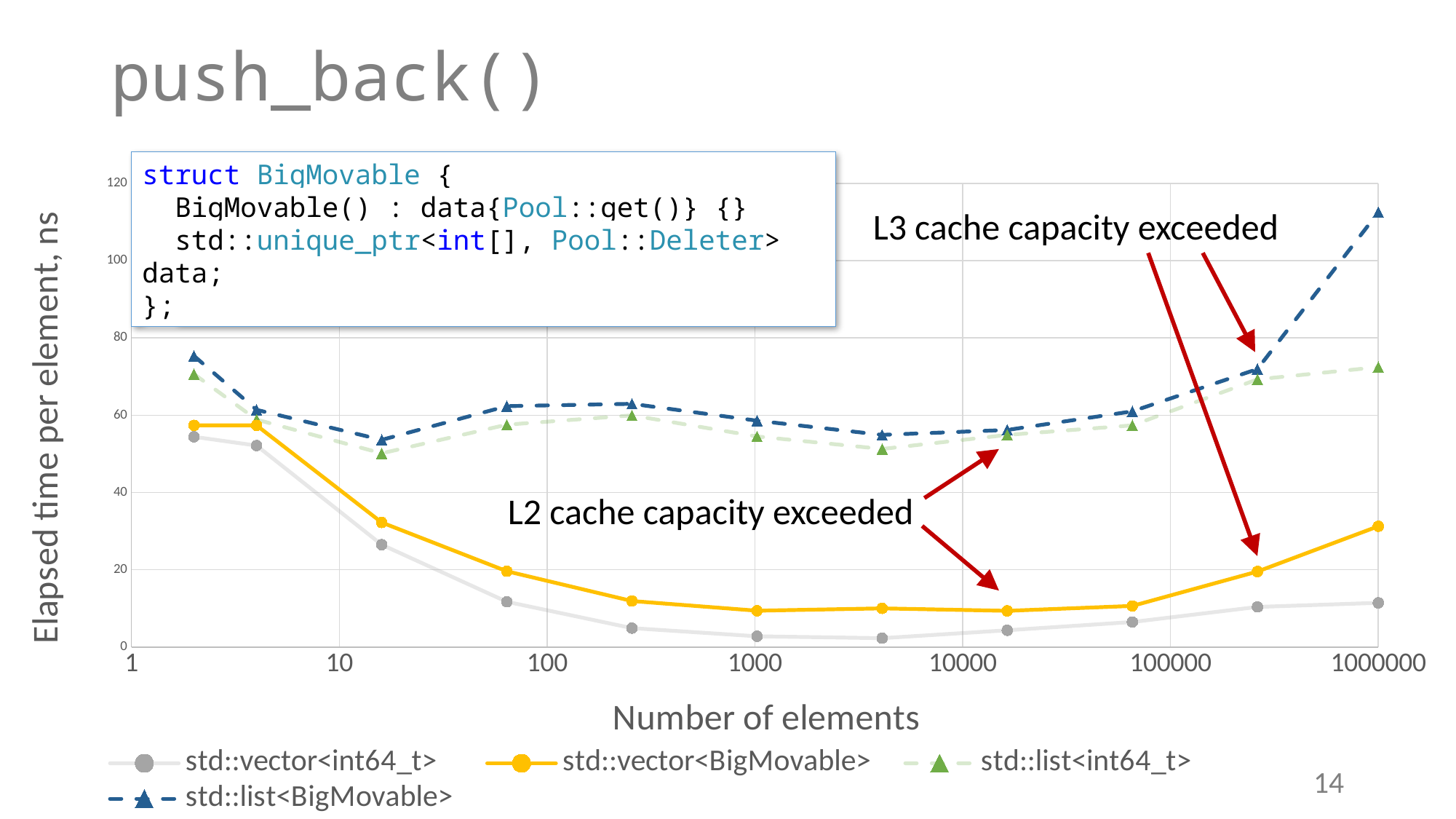
At 1000000 elements, which is larger: std::list<BigMovable> or std::vector<BigMovable>? std::list<BigMovable> How many series does the legend list? 4 Is the value for std::vector<BigMovable> at 1000000 elements greater or less than 20? greater Is the value for std::vector<int64_t> at 1000000 elements greater or less than 20? less Is the value for std::list<BigMovable> at 1000000 elements greater or less than 100? greater How many data points are plotted for the std::vector<int64_t> series? 11 What kind of chart is shown on the slide? line chart Does the std::vector<int64_t> series rise or fall as the number of elements increases from 1 to 1000? fall Which series has the lowest elapsed time per element at 1000000 elements? std::vector<int64_t> Which series has the highest elapsed time per element at 1000000 elements? std::list<BigMovable> What is the title of the x axis? Number of elements